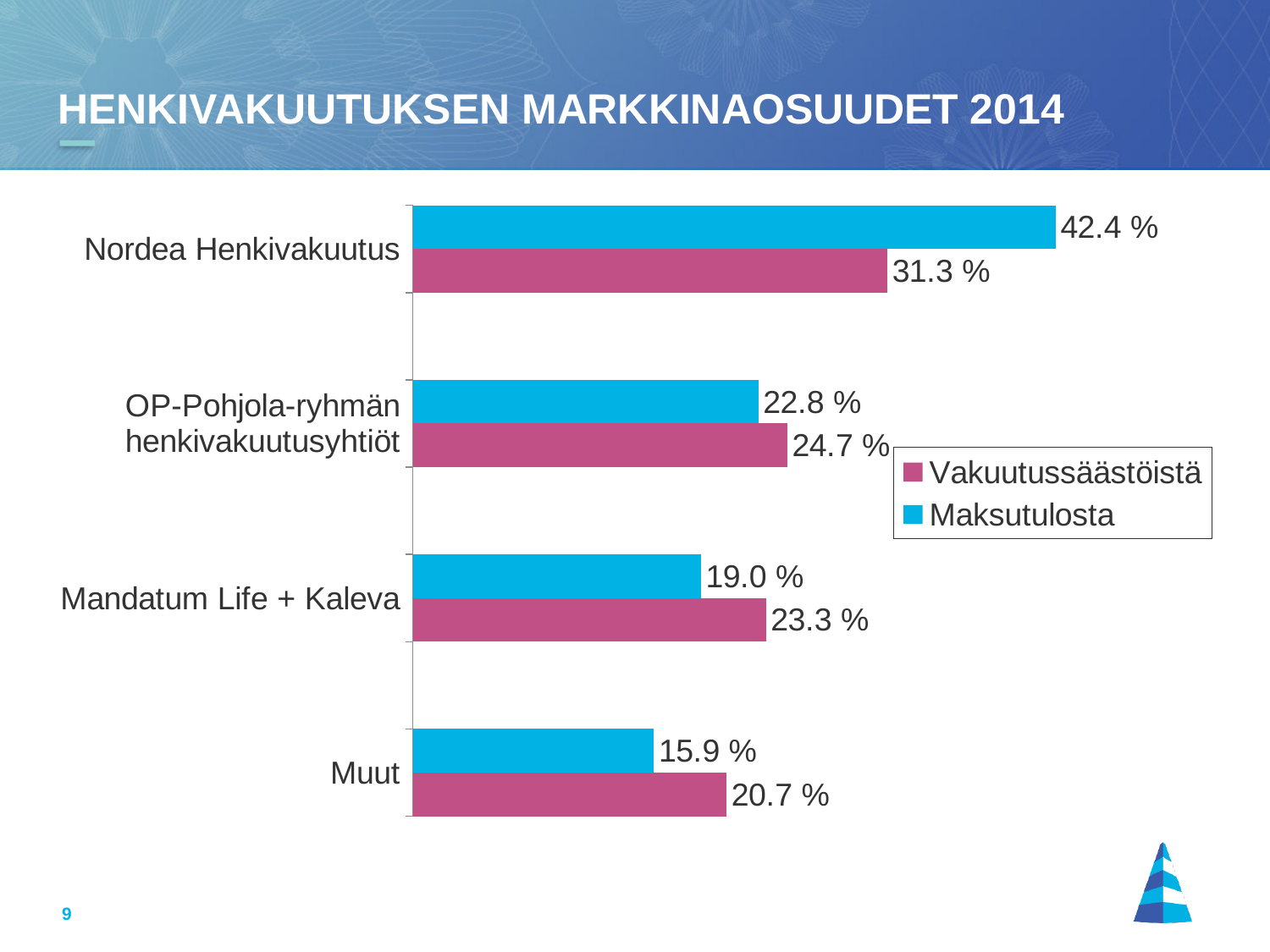
How many series does the legend list? 2 What is the title of the slide? HENKIVAKUUTUKSEN MARKKINAOSUUDET 2014 Which colour represents the Maksutulosta series? Blue How many categories are shown on the chart? 4 What is the Vakuutussäästöistä value for Mandatum Life + Kaleva? 23.3 % For OP-Pohjola-ryhmän henkivakuutusyhtiöt, which is larger: Vakuutussäästöistä or Maksutulosta? Vakuutussäästöistä Which category has the highest Vakuutussäästöistä value? Nordea Henkivakuutus What is the Maksutulosta value for Nordea Henkivakuutus? 42.4 % What kind of chart is shown on the slide? Bar chart What is the Maksutulosta value for Muut? 15.9 % What is the difference between the Maksutulosta and Vakuutussäästöistä values for Nordea Henkivakuutus? 11.1 % Which category has the lowest Maksutulosta value? Muut